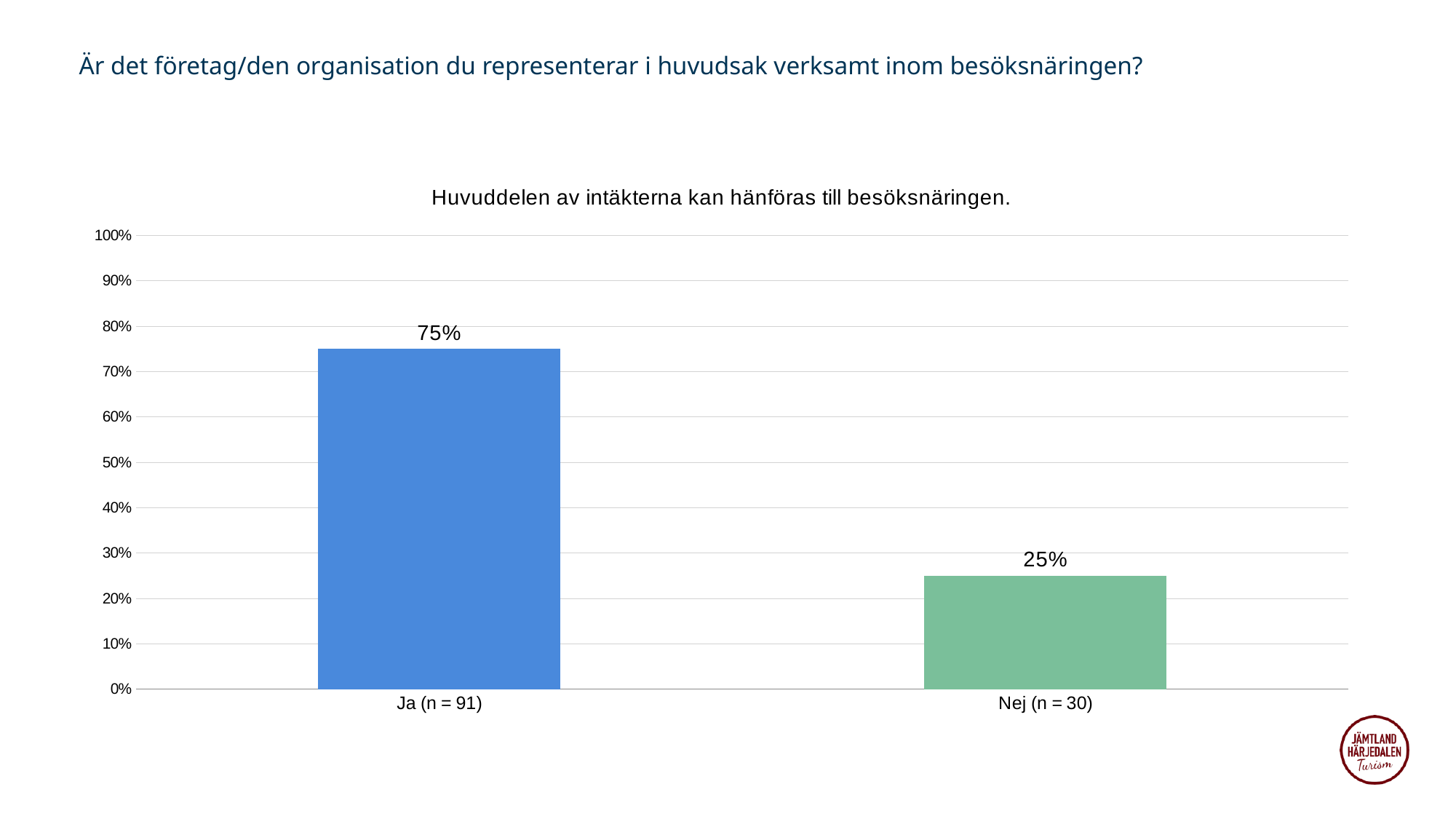
What is the value for "Nej (n = 30)"? 25% What is the title of the chart? Huvuddelen av intäkterna kan hänföras till besöksnäringen. Is the value for "Ja (n = 91)" greater or less than 70%? greater Which category has the lowest value? Nej (n = 30) Is the value for "Nej (n = 30)" greater or less than 30%? less What colour is the bar for "Nej (n = 30)"? green Which is larger, the value for "Ja (n = 91)" or the value for "Nej (n = 30)"? Ja (n = 91) How many categories are shown in the chart? 2 Which category has the highest value? Ja (n = 91) What kind of chart is shown on the slide? bar chart What is the difference between the values for "Ja (n = 91)" and "Nej (n = 30)"? 50% What is the value for "Ja (n = 91)"? 75%